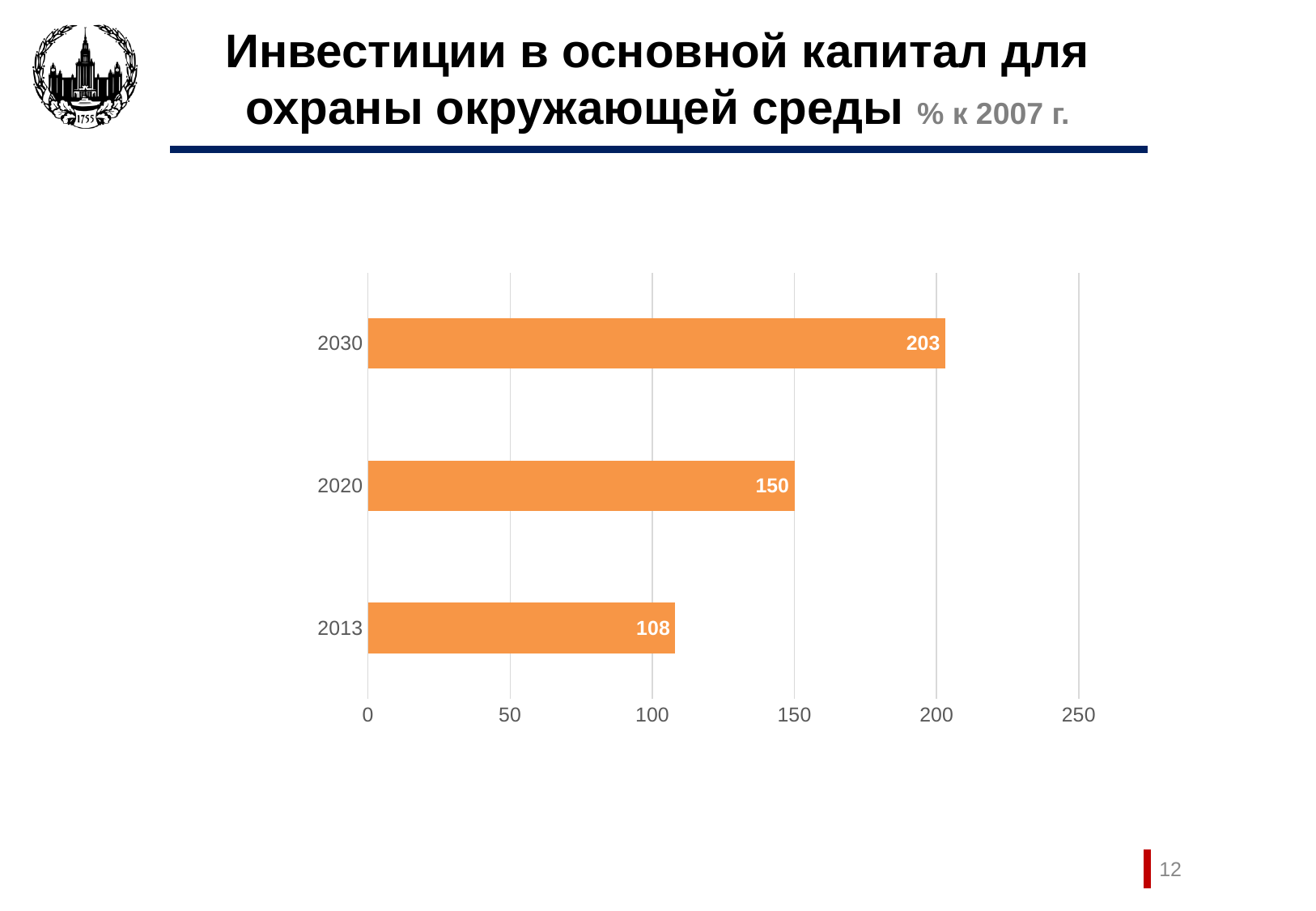
What unit is indicated in the chart title? % к 2007 г. Which year has the highest value? 2030 What kind of chart is shown on the slide? bar chart What is the value for 2020? 150 What is the difference between the values for 2030 and 2013? 95 Which year has the lowest value? 2013 Which is larger, the value for 2020 or the value for 2013? 2020 Is the value for 2030 greater or less than 200? greater What is the difference between the values for 2020 and 2013? 42 What is the value for 2030? 203 How many years are shown in the chart? 3 What is the value for 2013? 108